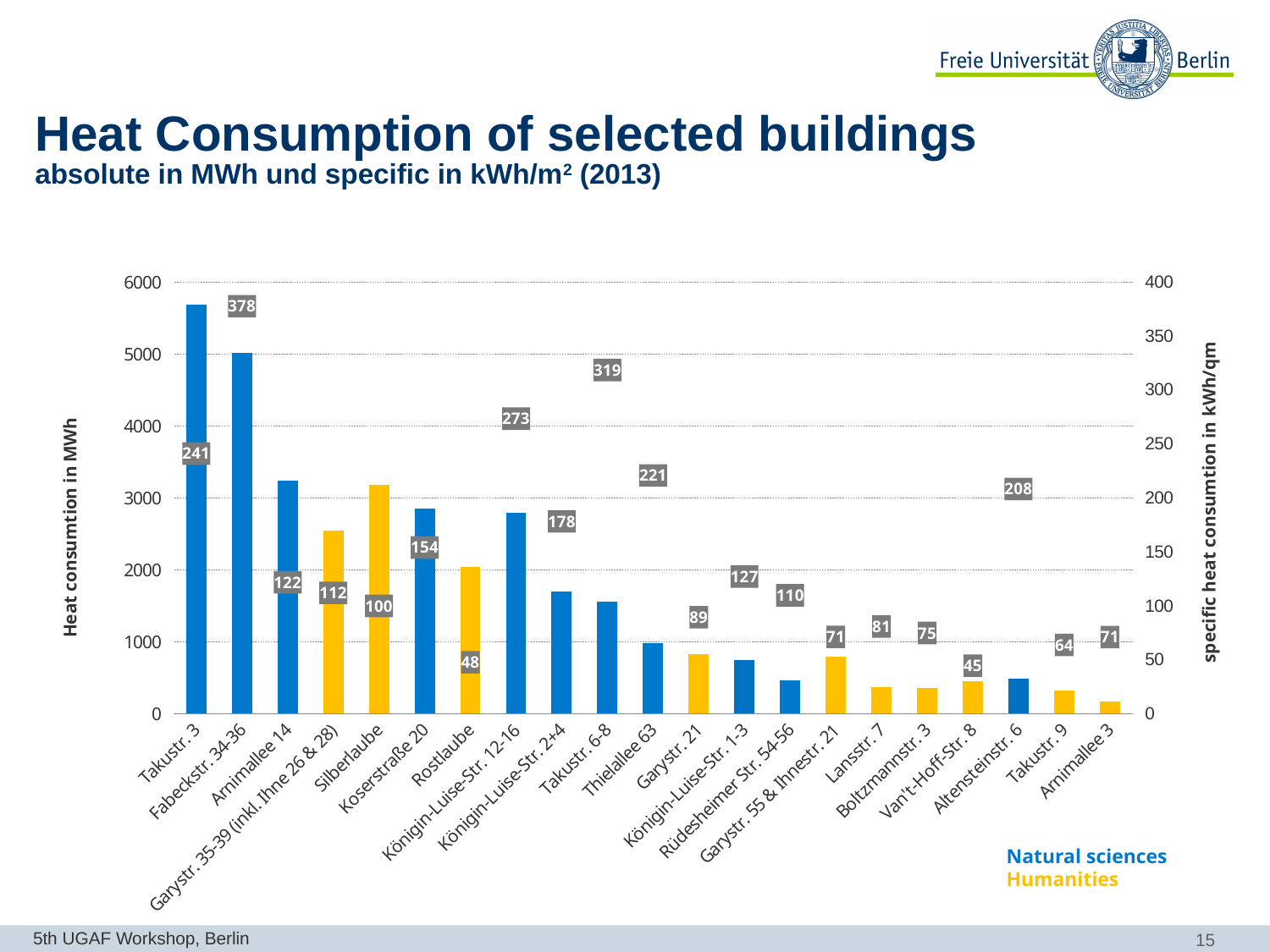
What colour are the bars for Humanities buildings? Yellow What is the specific heat consumption (kWh/qm) shown for Rostlaube? 48 What is the specific heat consumption (kWh/qm) shown for Altensteinstr. 6? 208 What is the difference between the specific heat consumption labels of Takustr. 6-8 and Thielallee 63? 98 How many buildings are shown on the x axis of the chart? 21 Which building has the lowest specific heat consumption label? Van't-Hoff-Str. 8 What is the specific heat consumption (kWh/qm) shown for Fabeckstr. 34-36? 378 Which building has the highest specific heat consumption label? Fabeckstr. 34-36 Is the absolute heat consumption bar for Koserstraße 20 greater or less than 2000 MWh? greater Which has the higher specific heat consumption label, Koserstraße 20 or Königin-Luise-Str. 2+4? Königin-Luise-Str. 2+4 Is the absolute heat consumption bar for Takustr. 3 greater or less than 5000 MWh? greater Which building has the tallest absolute heat consumption bar? Takustr. 3